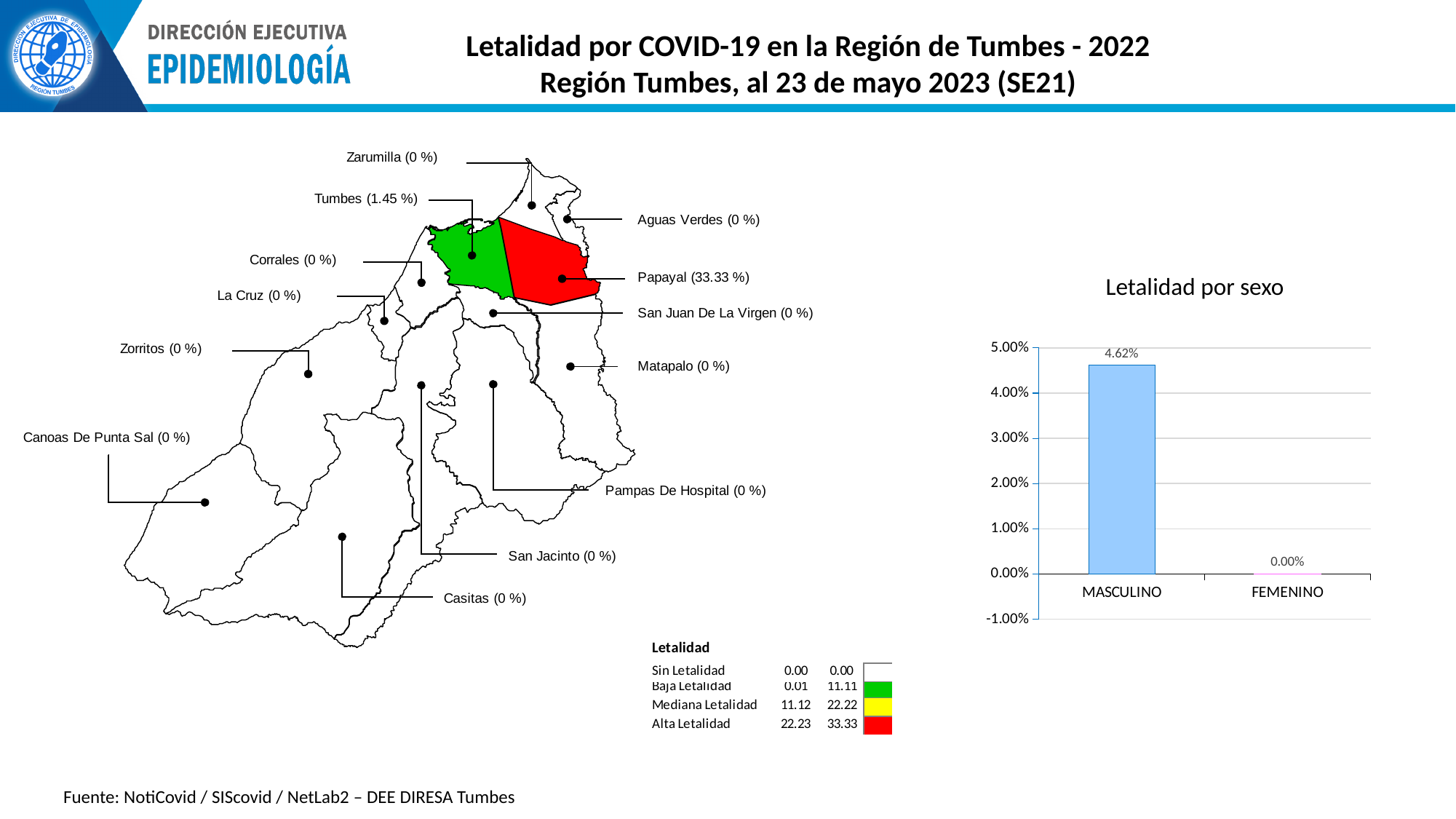
In the 'Letalidad por sexo' chart, which category has the highest value? MASCULINO How many categories are shown on the x axis of the 'Letalidad por sexo' chart? 2 In the 'Letalidad por sexo' chart, what is the value for FEMENINO? 0.00% What kind of chart is 'Letalidad por sexo'? bar chart On the map, what is the lethality value shown for Tumbes? 1.45 % On the map, what is the lethality value shown for Papayal? 33.33 % On the map, which district has the highest lethality value? Papayal In the 'Letalidad por sexo' chart, is the value for MASCULINO greater or less than 4.00%? greater In the 'Letalidad por sexo' chart, what is the value for MASCULINO? 4.62% What is the title of the bar chart on the right side of the slide? Letalidad por sexo In the 'Letalidad por sexo' chart, what is the difference between the MASCULINO and FEMENINO values? 4.62% In the 'Letalidad por sexo' chart, which category has the lowest value? FEMENINO